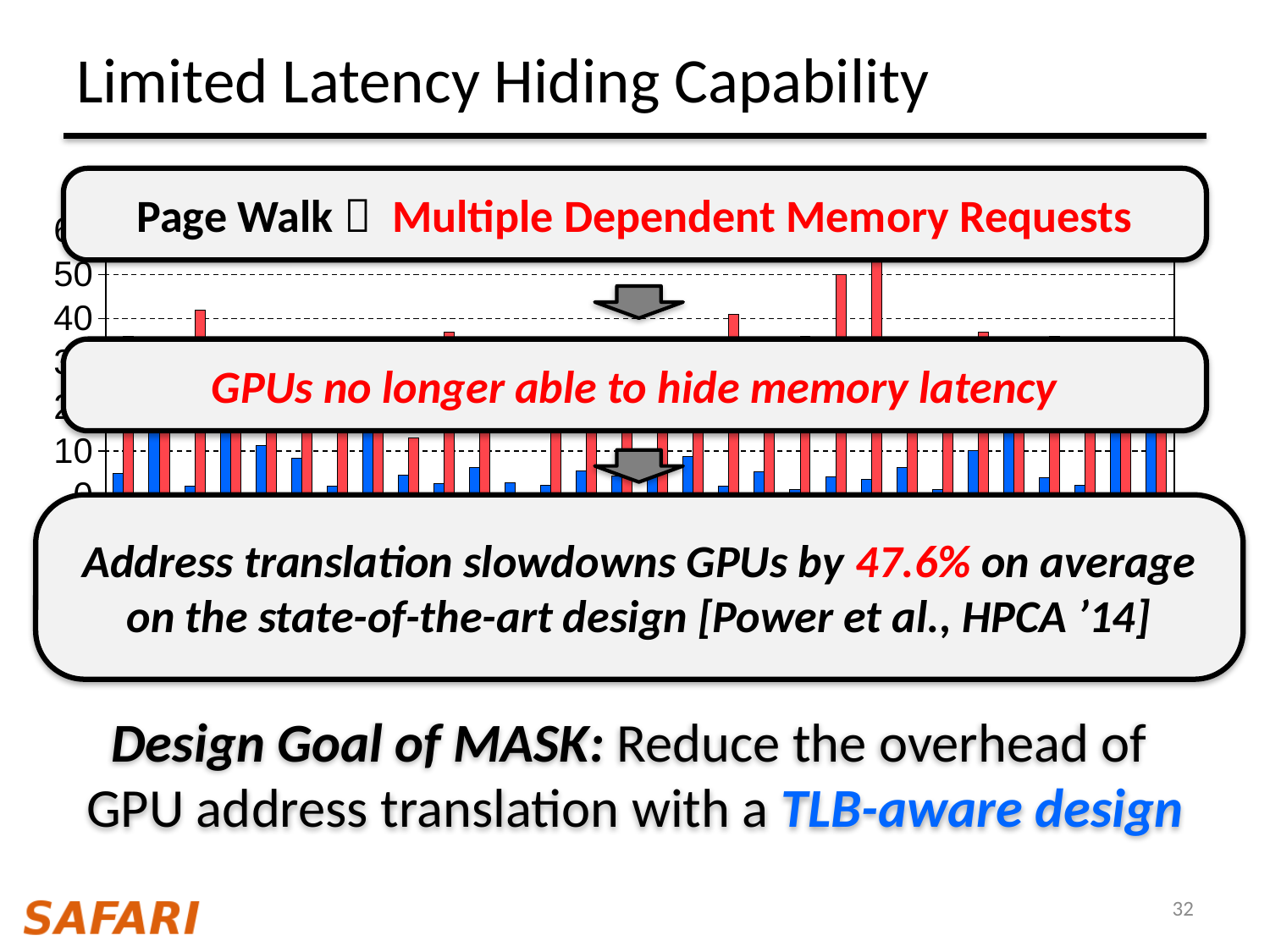
How many differently coloured bar series are plotted in the chart? 2 Does the tallest red bar in the chart reach a value greater or less than 50? greater What two colours are the bars in the chart? red and blue What kind of chart is shown on the slide? bar chart What is the y-axis tick label shown directly below 50? 40 Which colour of bars reaches the highest value in the chart? red